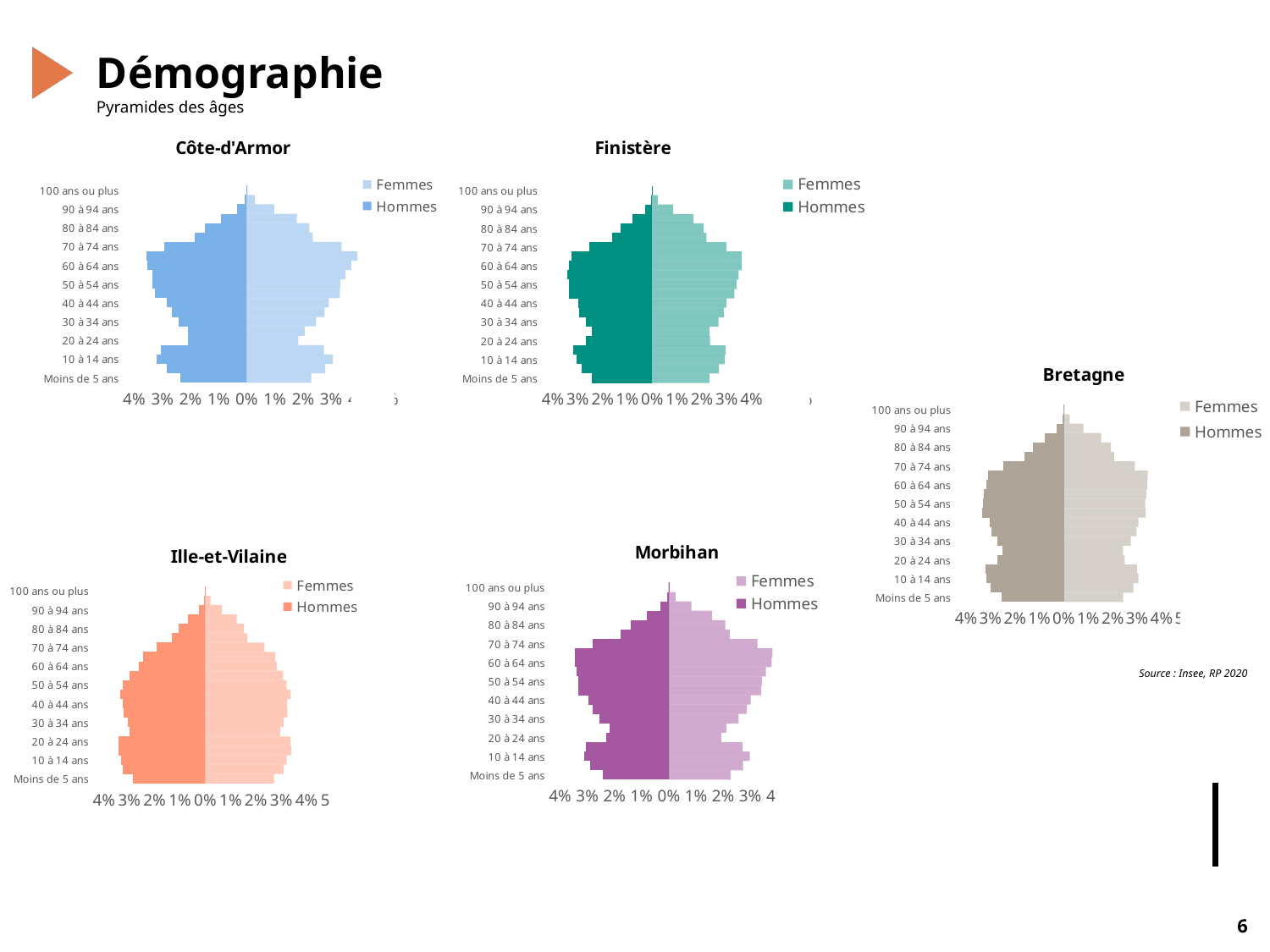
In the Ille-et-Vilaine chart, is the Femmes value for 100 ans ou plus greater or less than 1%? less In the Morbihan chart, is the Femmes value for 60 à 64 ans greater or less than 3%? greater How many series does the legend of the Finistère chart list? 2 In the Bretagne chart, is the Hommes value for 60 à 64 ans greater or less than 2%? greater What source is cited for the charts on the slide? Insee, RP 2020 In the Morbihan chart, which age group has the lowest Hommes value? 100 ans ou plus How many population pyramid charts are shown on the slide? 5 What are the two legend entries on the Morbihan chart? Femmes and Hommes What kind of chart is the Côte-d'Armor chart? bar chart In the Côte-d'Armor chart, which Femmes value is larger: 60 à 64 ans or 100 ans ou plus? 60 à 64 ans